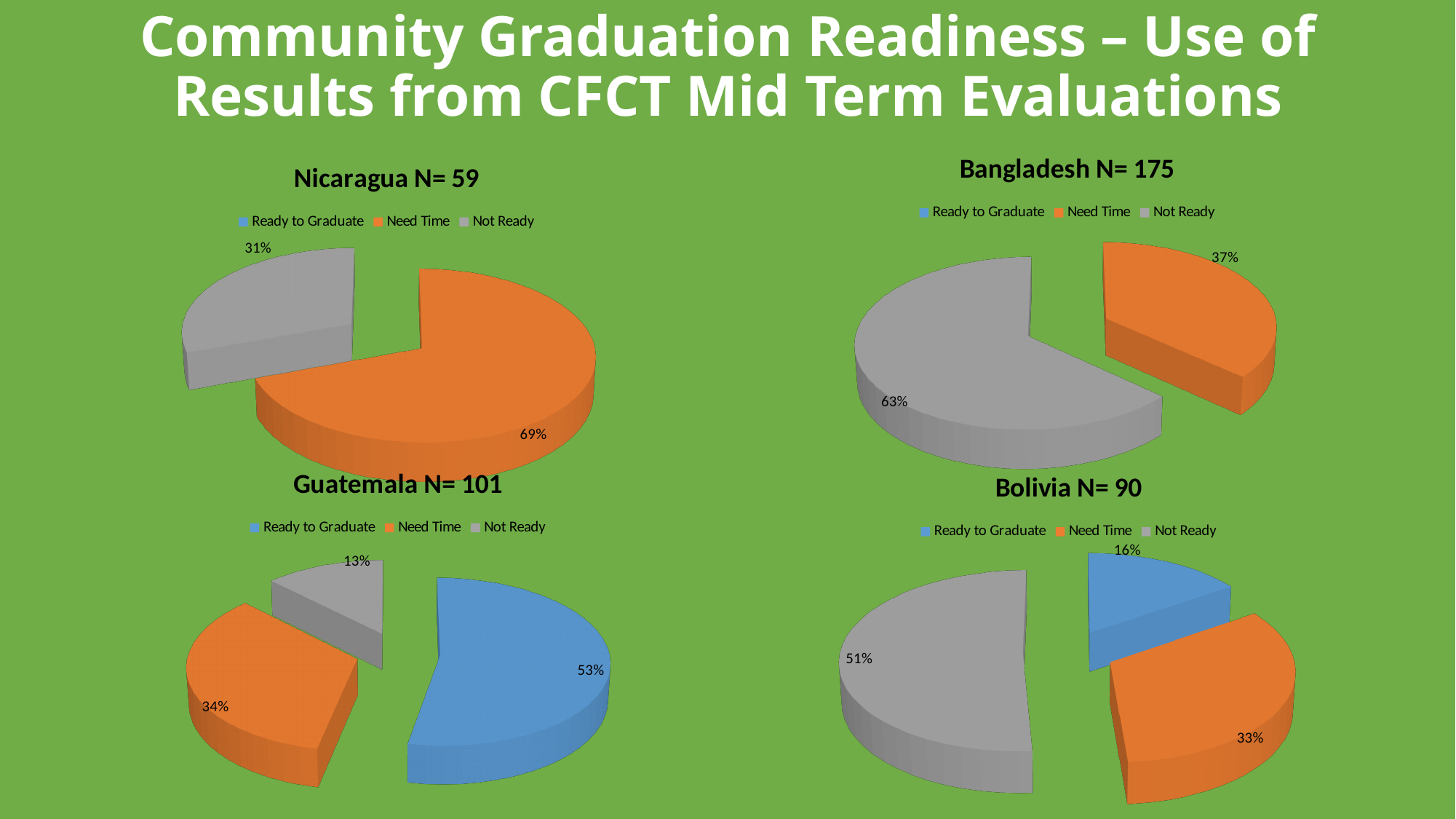
In the Guatemala N= 101 chart, is the Need Time slice larger or smaller than the Not Ready slice? larger In the Bolivia N= 90 chart, which category has the largest slice? Not Ready How many entries does the legend of the Guatemala N= 101 chart list? 3 In the Nicaragua N= 59 chart, what share of communities are labelled Need Time? 69% In the Bangladesh N= 175 chart, what percentage is shown for Need Time? 37% What type of chart is used for the Bangladesh N= 175 data? pie chart In the Bolivia N= 90 chart, what percentage is shown for Ready to Graduate? 16% In the Guatemala N= 101 chart, which category has the smallest slice? Not Ready In the Bolivia N= 90 chart, what is the difference between the Not Ready and Need Time percentages? 18% In the Guatemala N= 101 chart, what percentage is shown for Ready to Graduate? 53% In the Bangladesh N= 175 chart, what percentage is shown for Not Ready? 63% In the Nicaragua N= 59 chart, what percentage is shown for Not Ready? 31%